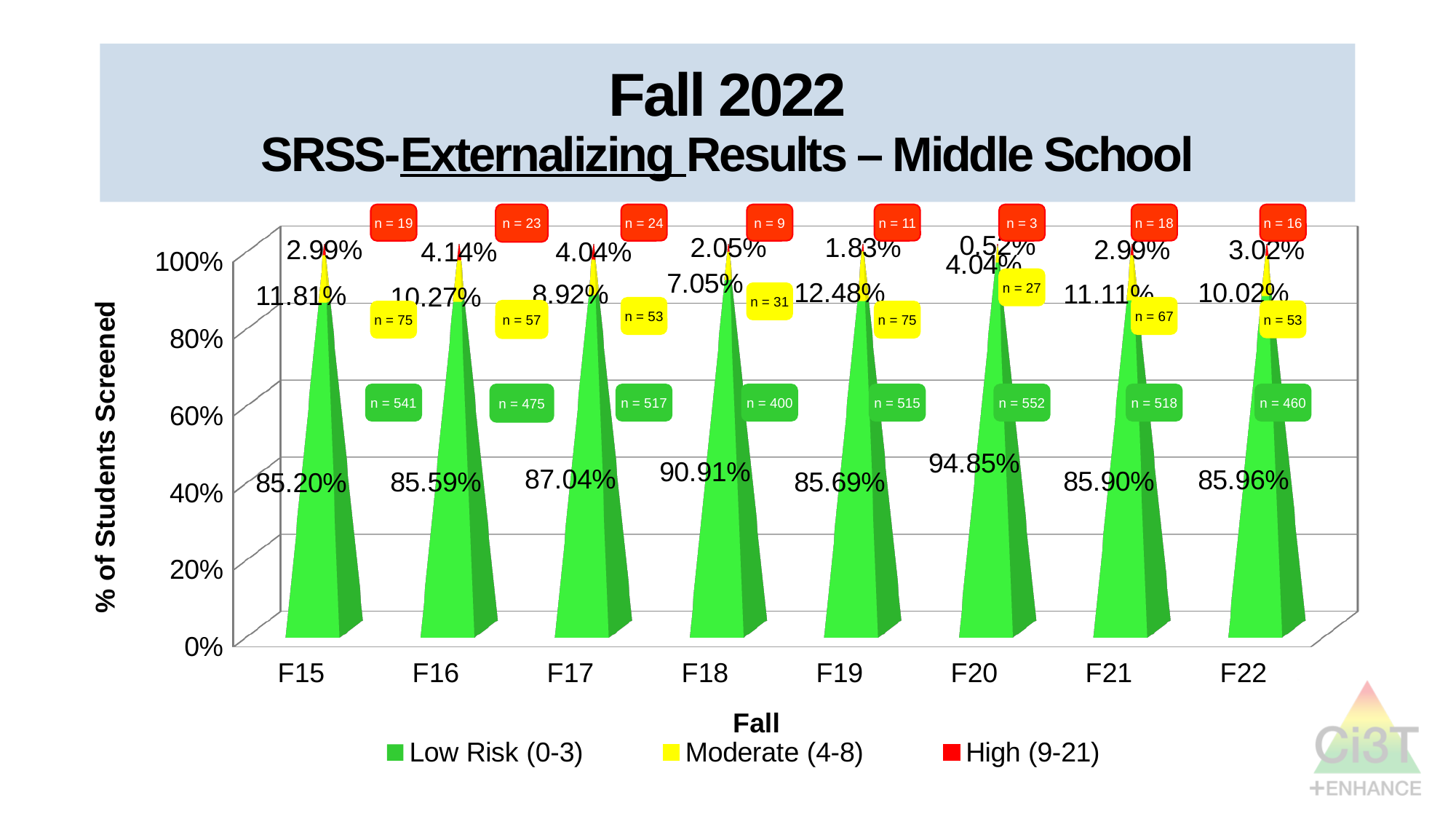
Which fall has the lowest High (9-21) percentage? F20 Which fall has the highest Low Risk (0-3) percentage? F20 What is the difference between the Low Risk (0-3) percentage for F18 and for F15? 5.71% What is the Moderate (4-8) percentage for F19? 12.48% How many fall screening periods are shown on the x axis? 8 Which colour represents the High (9-21) series in the legend? Red How many series does the legend list? 3 How many students were in the Low Risk (0-3) group in F18? n = 400 What kind of chart is shown on the slide? Stacked bar chart Which is larger, the Moderate (4-8) percentage for F15 or for F21? F15 What is the Low Risk (0-3) percentage for F20? 94.85% What is the High (9-21) percentage for F16? 4.14%